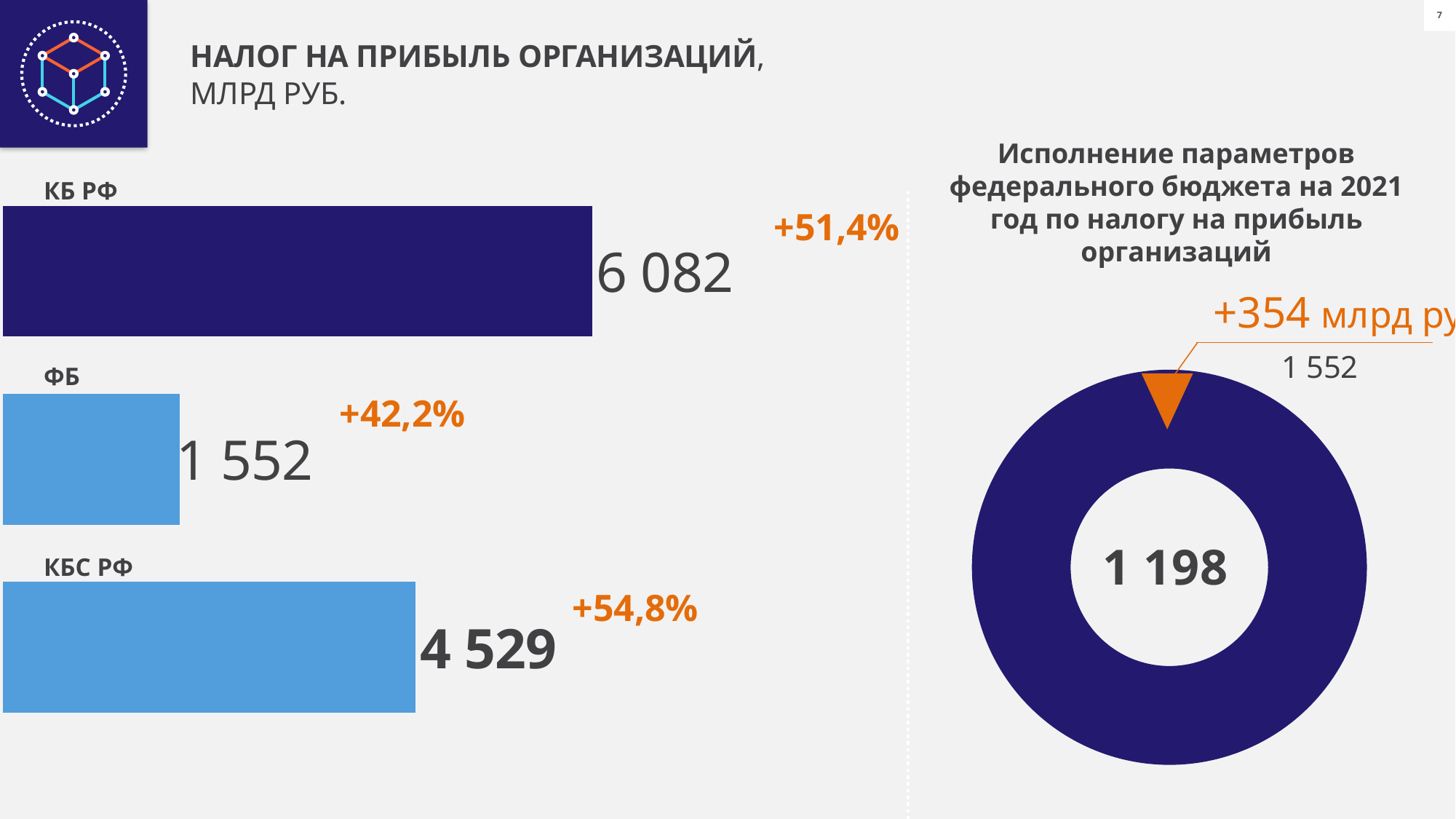
On the bar chart on the left, what growth percentage is shown next to the КБС РФ bar? +54,8% On the bar chart on the left, what is the value for ФБ? 1 552 On the donut chart on the right, what value is printed in the centre? 1 198 On the bar chart on the left, what is the value for КБ РФ? 6 082 On the bar chart on the left, what is the value for КБС РФ? 4 529 On the bar chart on the left, which category has the highest value? КБ РФ On the bar chart on the left, how many categories are shown? 3 What kind of chart is shown on the right of the slide? Donut chart On the bar chart on the left, which category has the lowest value? ФБ On the bar chart on the left, what is the difference between the values for КБ РФ and КБС РФ? 1 553 On the bar chart on the left, which is larger: the value for КБС РФ or the value for ФБ? КБС РФ What kind of chart is shown on the left of the slide? Bar chart